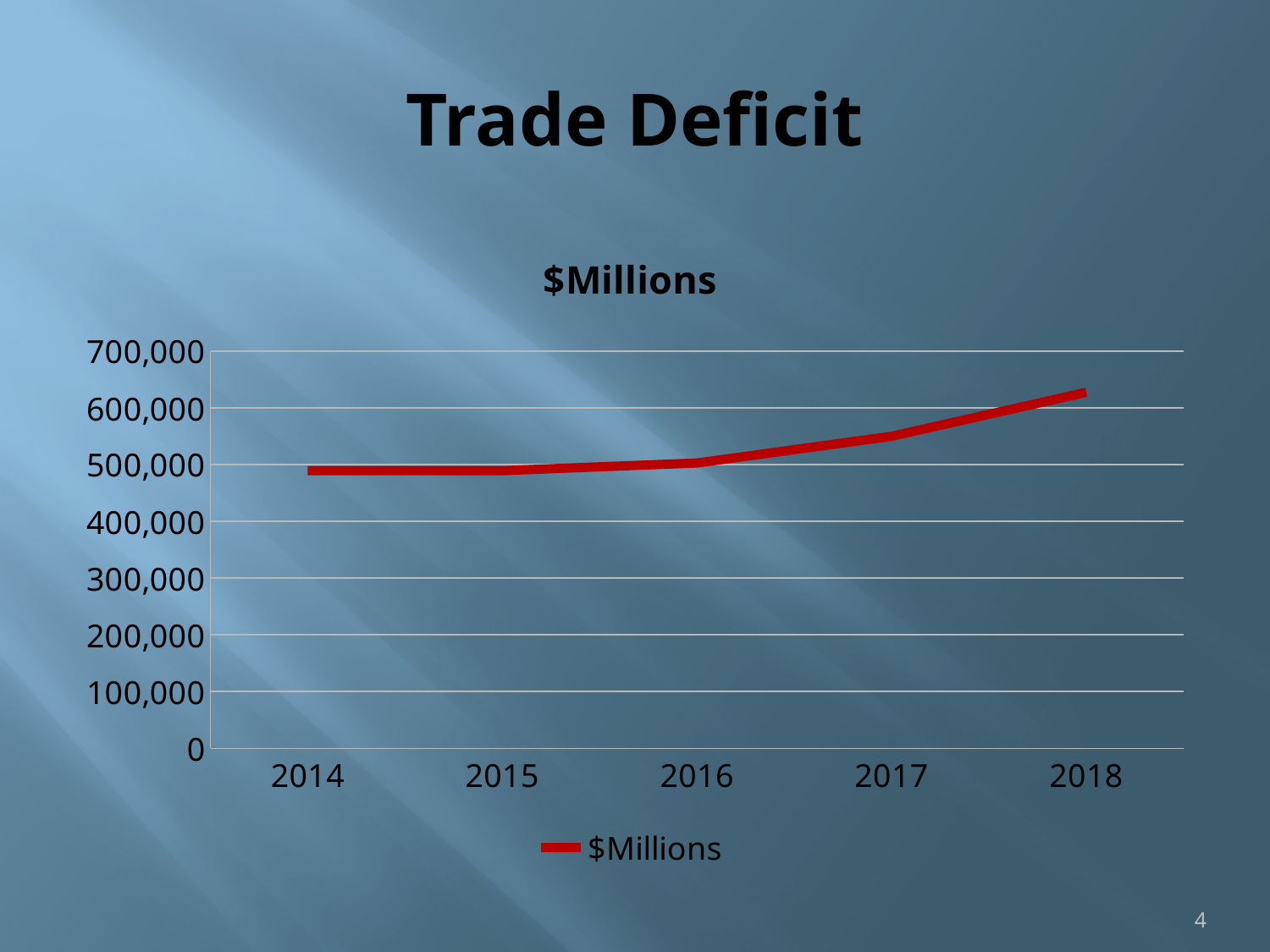
Is the value for 2017 greater or less than 500,000? greater Is the value for 2014 greater or less than 400,000? greater How many series does the legend list? 1 Which year has the highest trade deficit value? 2018 Which is larger, the value for 2018 or the value for 2014? 2018 Do the values rise or fall from 2014 to 2018? rise Is the value for 2018 greater or less than 700,000? less Which is larger, the value for 2017 or the value for 2015? 2017 What is the title shown above the chart? $Millions What kind of chart is shown on the slide? line chart How many years are plotted on the x axis? 5